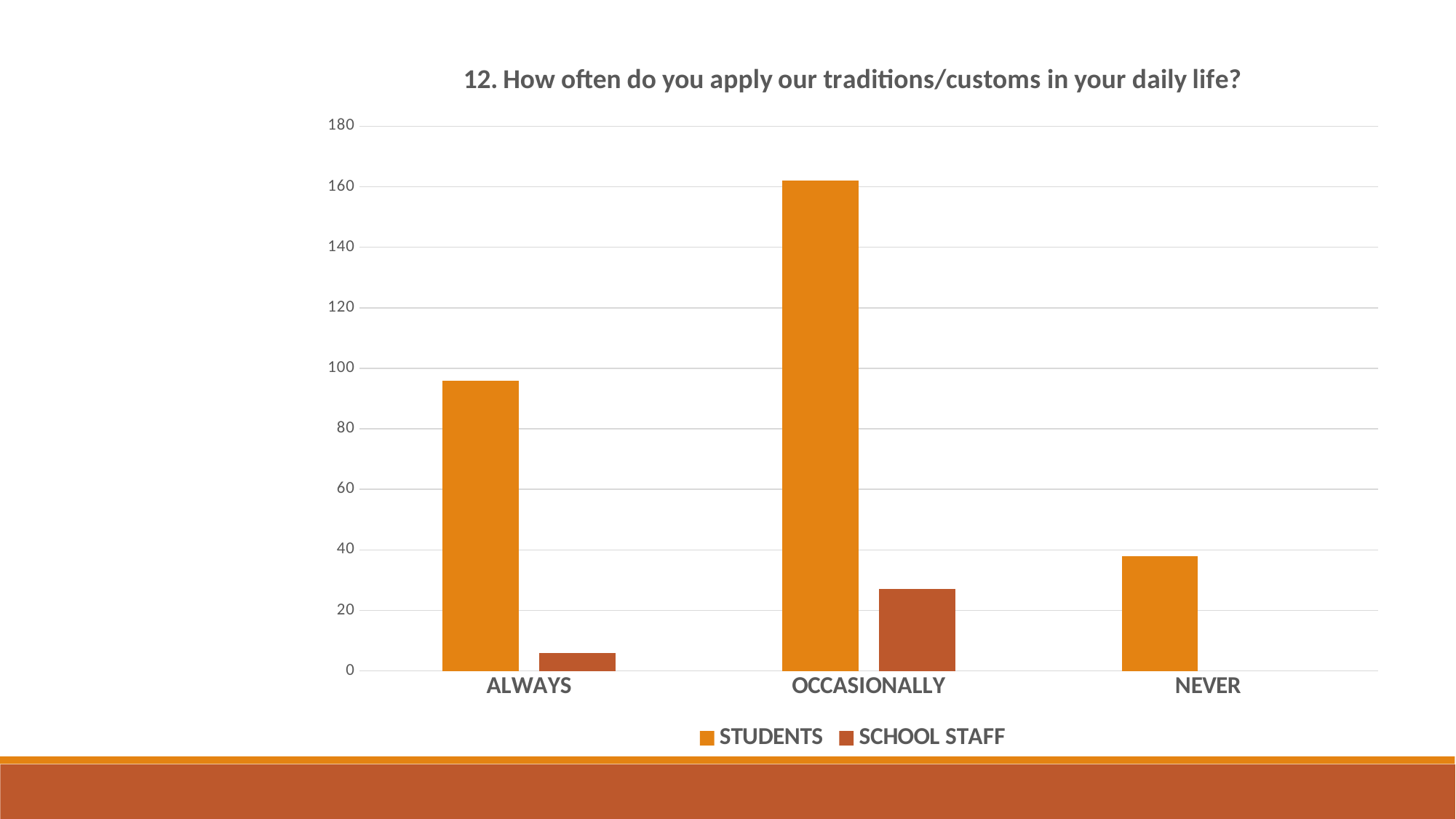
For ALWAYS, which series has the larger value, STUDENTS or SCHOOL STAFF? STUDENTS How many categories are shown on the x axis? 3 What kind of chart is shown on the slide? bar chart Is the SCHOOL STAFF value for OCCASIONALLY greater or less than 40? less Which category has the highest value for STUDENTS? OCCASIONALLY Which category has the highest value for SCHOOL STAFF? OCCASIONALLY Is the SCHOOL STAFF value for ALWAYS greater or less than 20? less How many series does the legend list? 2 Which category has the lowest value for STUDENTS? NEVER Is the STUDENTS value for ALWAYS greater or less than 100? less What is the title of the chart? 12. How often do you apply our traditions/customs in your daily life?